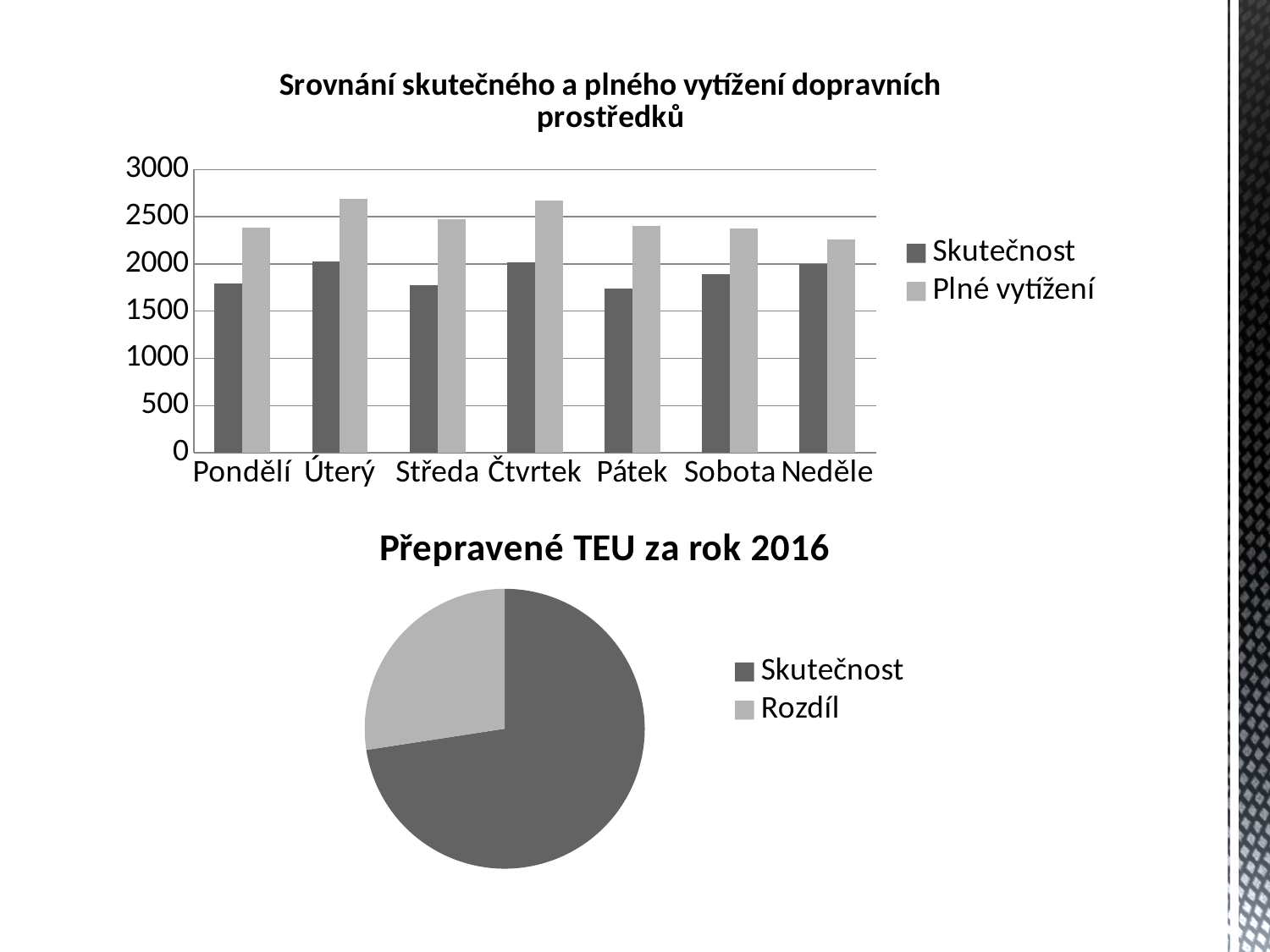
In the top bar chart, is the value for Plné vytížení on Neděle greater or less than 2500? less In the top bar chart, how many series does the legend list? 2 In the top bar chart, which is larger on Středa: Skutečnost or Plné vytížení? Plné vytížení In the top bar chart, which is larger for Skutečnost: Úterý or Pátek? Úterý In the bottom pie chart, which slice is larger: Skutečnost or Rozdíl? Skutečnost In the top bar chart, how many categories (days) are shown on the x axis? 7 In the bottom pie chart, how many slices does the legend list? 2 In the top bar chart, is the value for Skutečnost on Pátek greater or less than 2000? less In the top bar chart, which day has the lowest value for Plné vytížení? Neděle What kind of chart is the top chart, 'Srovnání skutečného a plného vytížení dopravních prostředků'? Bar chart In the top bar chart, is the value for Plné vytížení on Úterý greater or less than 2500? greater What kind of chart is the bottom chart, 'Přepravené TEU za rok 2016'? Pie chart